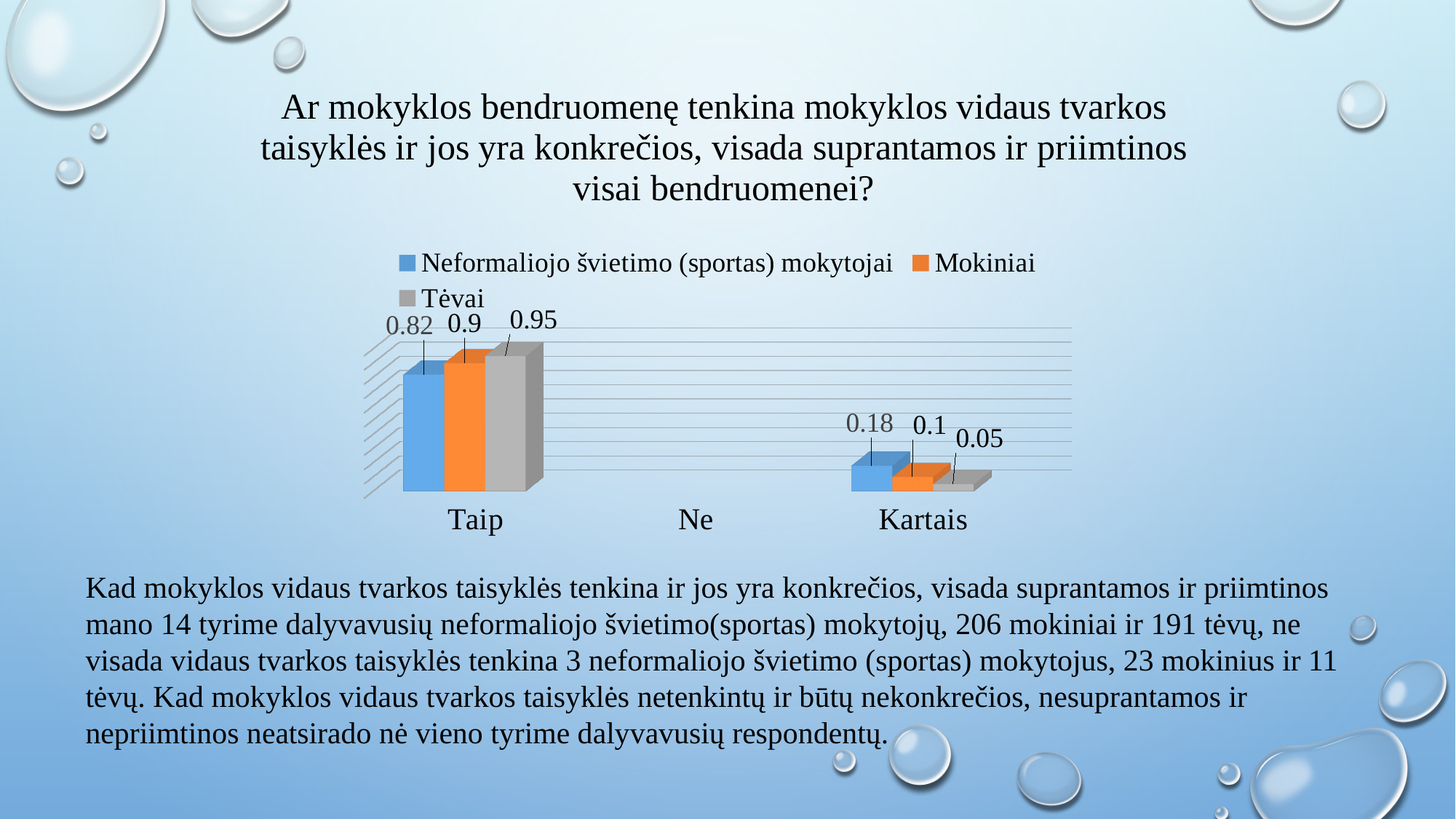
How many categories are shown on the x axis? 3 Which series has the lowest value in the Kartais category? Tėvai Which category has no visible bars for any series? Ne Which series has the highest value in the Taip category? Tėvai What is the value for Mokiniai in the Kartais category? 0.1 What is the value for Tėvai in the Taip category? 0.95 Which is larger: the Mokiniai value for Taip or the Mokiniai value for Kartais? Taip What is the difference between the Tėvai and Neformaliojo švietimo (sportas) mokytojai values in the Taip category? 0.13 What type of chart is shown on the slide? bar chart How many series does the legend list? 3 What is the value for Neformaliojo švietimo (sportas) mokytojai in the Taip category? 0.82 What is the difference between the Neformaliojo švietimo (sportas) mokytojai value and the Tėvai value in the Kartais category? 0.13